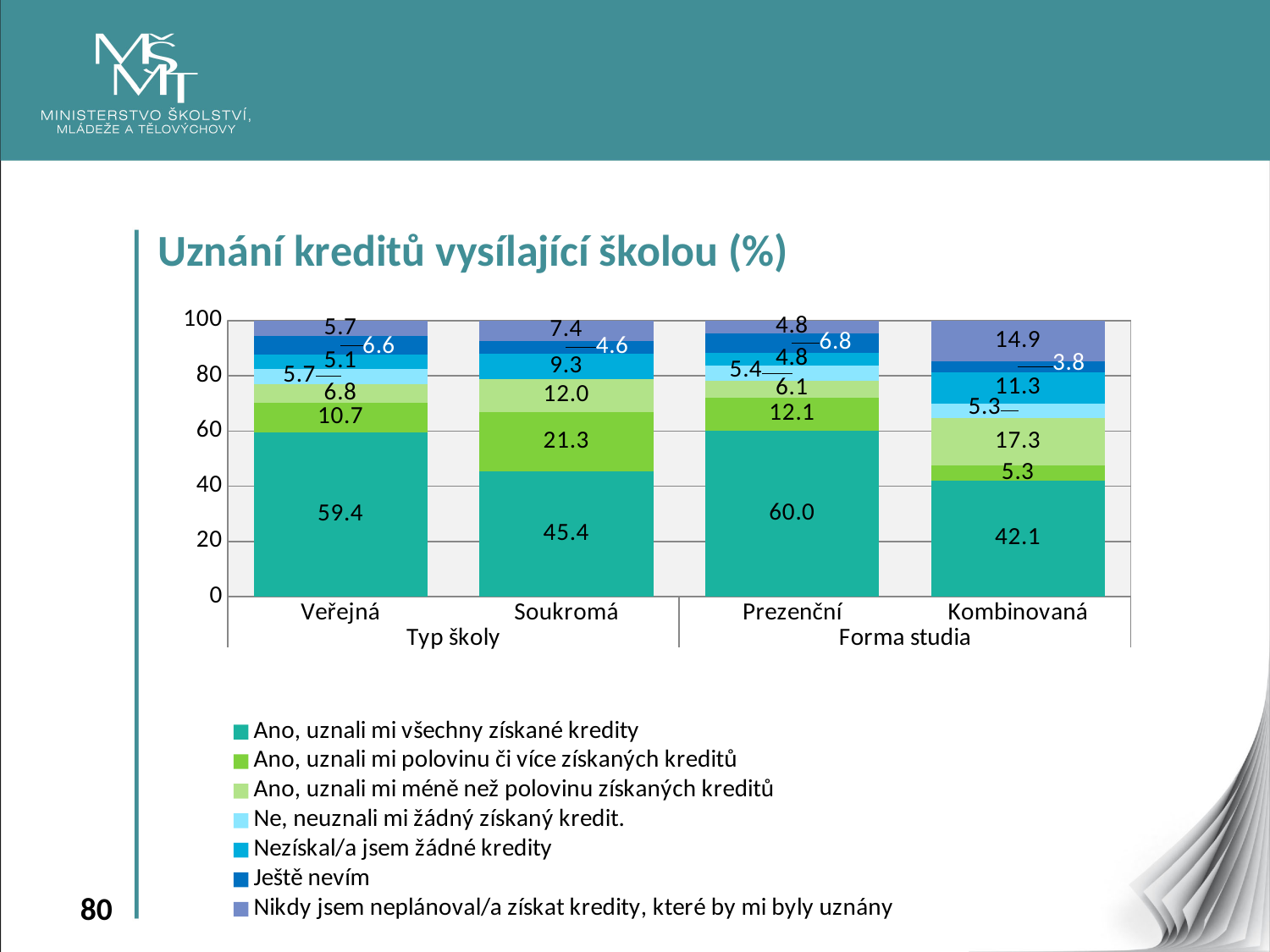
What is the difference between the 'Ano, uznali mi polovinu či více získaných kreditů' values for Soukromá and Veřejná? 10.6 How many categories are shown on the x axis? 4 Which category has the highest value for 'Ano, uznali mi všechny získané kredity'? Prezenční What kind of chart is shown on the slide? Stacked bar chart What is the value for 'Ano, uznali mi všechny získané kredity' in the Veřejná category? 59.4 Which category has the lowest value for 'Ano, uznali mi všechny získané kredity'? Kombinovaná What is the value for 'Nikdy jsem neplánoval/a získat kredity, které by mi byly uznány' in the Kombinovaná category? 14.9 What is the value for 'Nezískal/a jsem žádné kredity' in the Soukromá category? 9.3 How many series does the legend list? 7 Which has a larger value for 'Ano, uznali mi méně než polovinu získaných kreditů', Kombinovaná or Soukromá? Kombinovaná What is the difference between the 'Ano, uznali mi všechny získané kredity' values for Prezenční and Kombinovaná? 17.9 What is the value for 'Ještě nevím' in the Prezenční category? 6.8